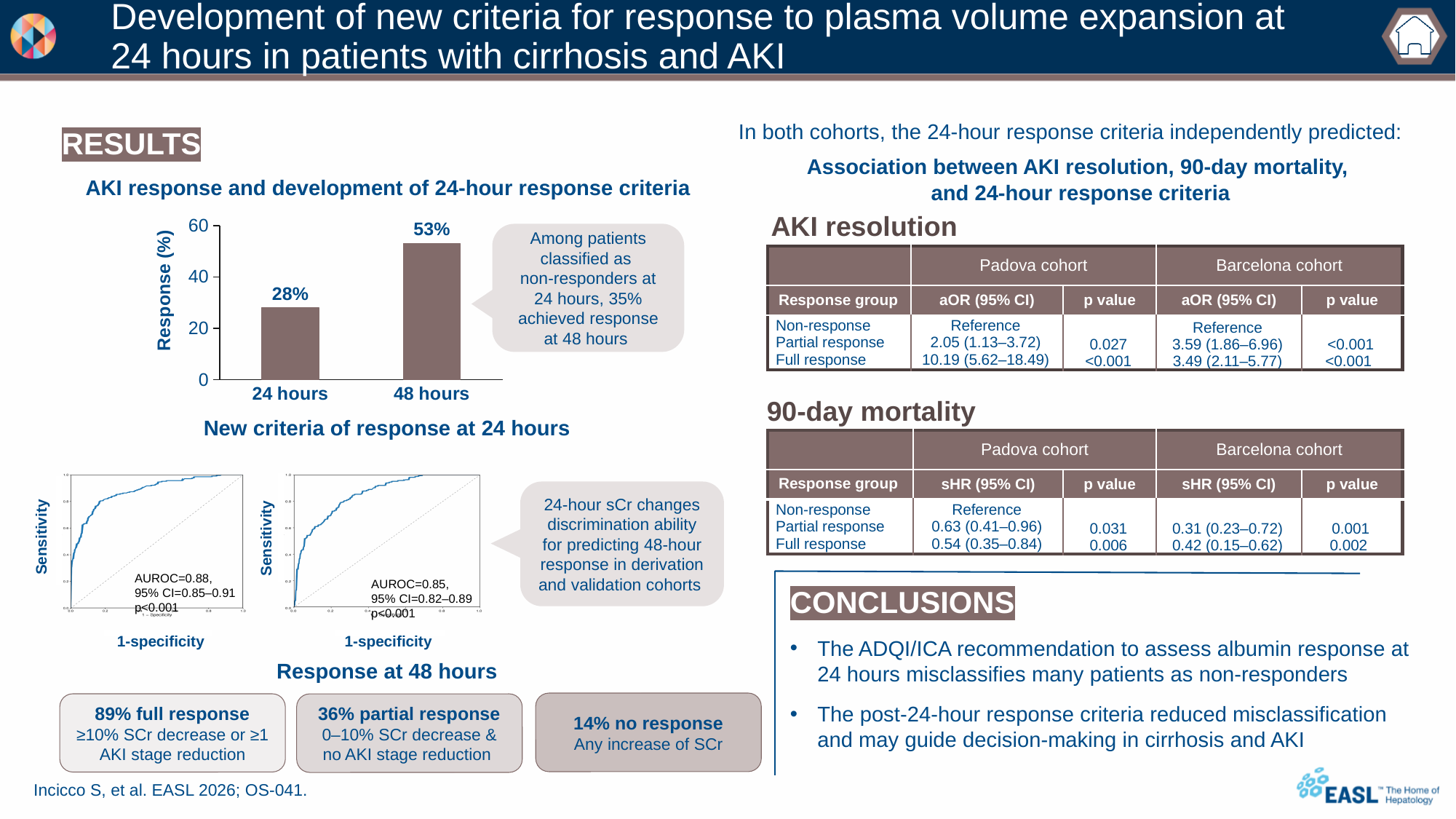
In the bar chart titled 'AKI response and development of 24-hour response criteria', which time point has the higher response? 48 hours In the bar chart titled 'AKI response and development of 24-hour response criteria', does the response rise or fall from 24 hours to 48 hours? Rise In the bar chart titled 'AKI response and development of 24-hour response criteria', what is the response at 48 hours? 53% In the right ROC curve under 'New criteria of response at 24 hours', what is the AUROC value? 0.85 In the left ROC curve under 'New criteria of response at 24 hours', what is the AUROC value? 0.88 In the bar chart titled 'AKI response and development of 24-hour response criteria', is the response at 48 hours greater or less than 40? greater In the bar chart titled 'AKI response and development of 24-hour response criteria', what is the difference in percentage points between the response at 48 hours and at 24 hours? 25 In the bar chart titled 'AKI response and development of 24-hour response criteria', what is the response at 24 hours? 28% In the bar chart titled 'AKI response and development of 24-hour response criteria', which time point has the lower response? 24 hours In the bar chart titled 'AKI response and development of 24-hour response criteria', what is the label of the y axis? Response (%) What kind of chart is the one titled 'AKI response and development of 24-hour response criteria'? Bar chart In the bar chart titled 'AKI response and development of 24-hour response criteria', how many bars are plotted? 2